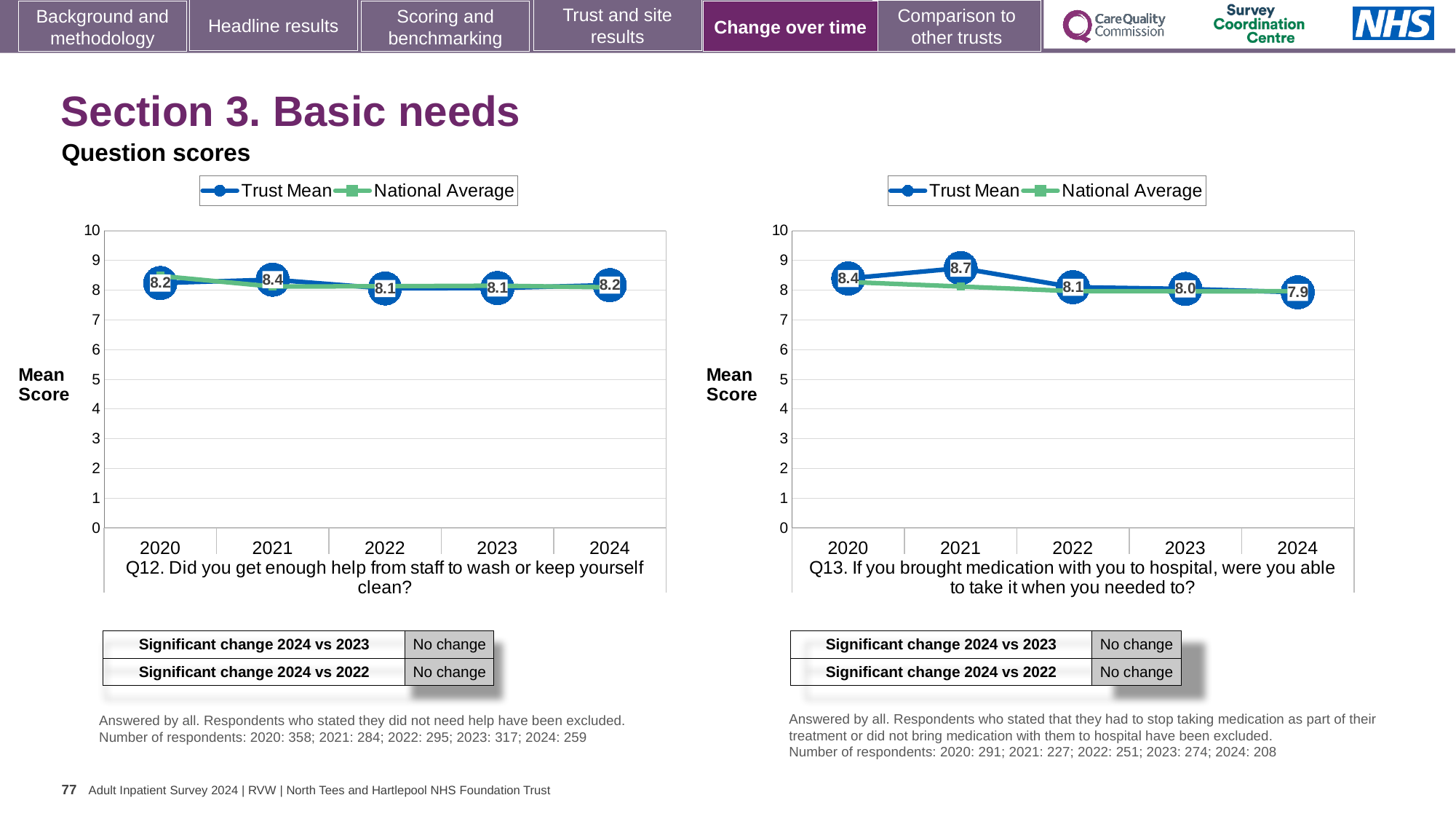
On the Q13 chart (right), which year has the lowest Trust Mean? 2024 How many years are plotted on the Q13 chart (right)? 5 On the Q13 chart (right), what is the Trust Mean for 2024? 7.9 On the Q12 chart (left), is the Trust Mean higher in 2021 or in 2022? 2021 On the Q13 chart (right), which year has the highest Trust Mean? 2021 On the Q12 chart (left), which year has the highest Trust Mean? 2021 On the Q13 chart (right), what is the difference between the Trust Mean in 2021 and in 2024? 0.8 How many series does the legend of the Q12 chart (left) list? 2 What type of chart is used for Q12 (left)? Line chart On the Q13 chart (right), does the Trust Mean rise or fall from 2021 to 2024? Fall On the Q12 chart (left), is the National Average for 2020 greater or less than 8? greater On the Q12 chart (left), what is the Trust Mean for 2021? 8.4